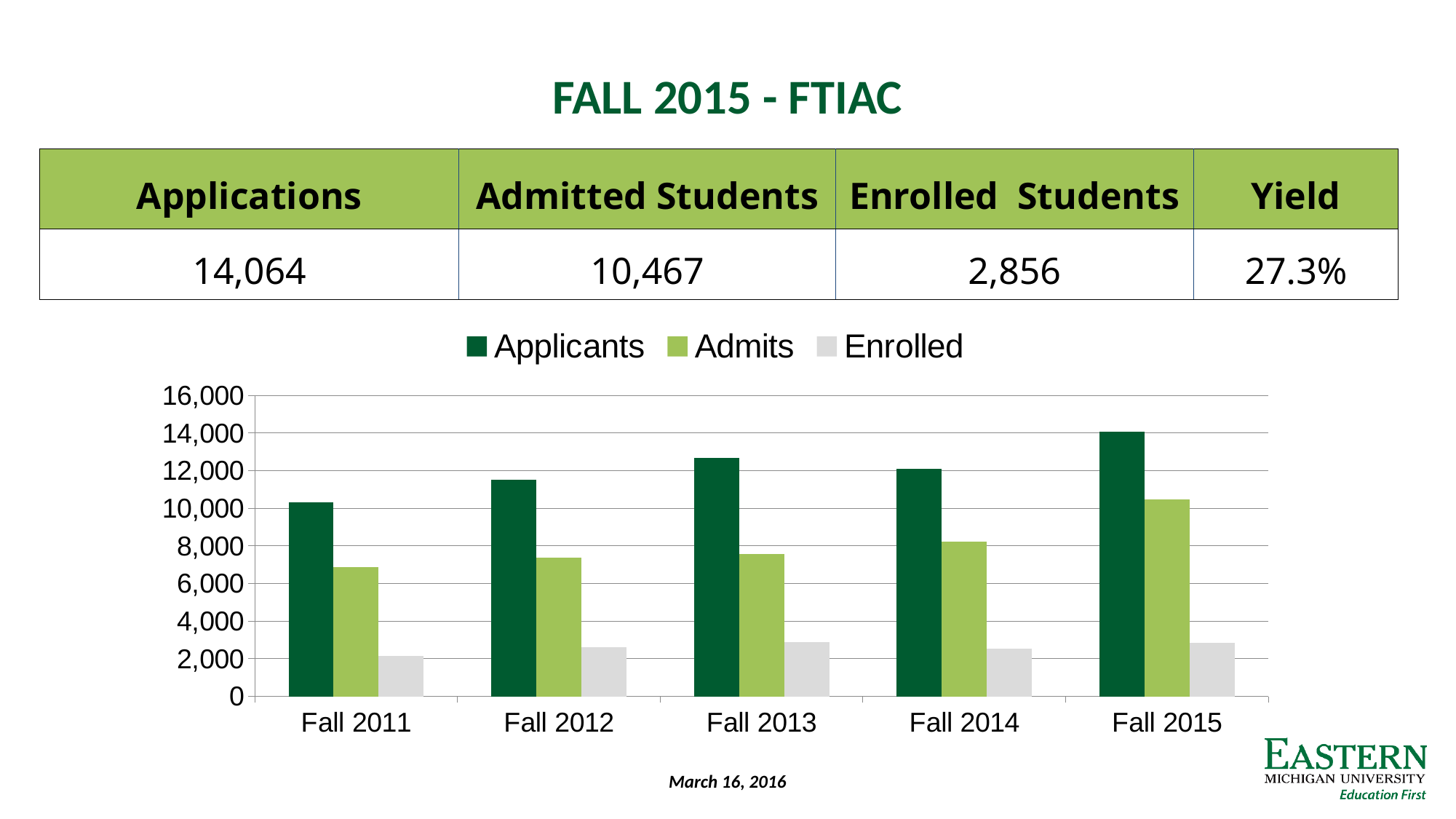
Is the number of Admits in Fall 2012 greater or less than 8,000? less Is the number of Applicants in Fall 2012 greater or less than 12,000? less What is the number of Applicants for Fall 2015, as given in the table on the slide? 14,064 Which fall term has the lowest number of Enrolled students? Fall 2011 Which fall term has the highest number of Admits? Fall 2015 What kind of chart is shown on the slide? bar chart How many series does the chart legend list? 3 Which fall term has the lowest number of Applicants? Fall 2011 Do the Admits values rise or fall from Fall 2011 to Fall 2015? rise How many fall terms are shown on the x axis of the chart? 5 Which is larger, the number of Applicants in Fall 2013 or in Fall 2014? Fall 2013 Which fall term has the highest number of Applicants? Fall 2015